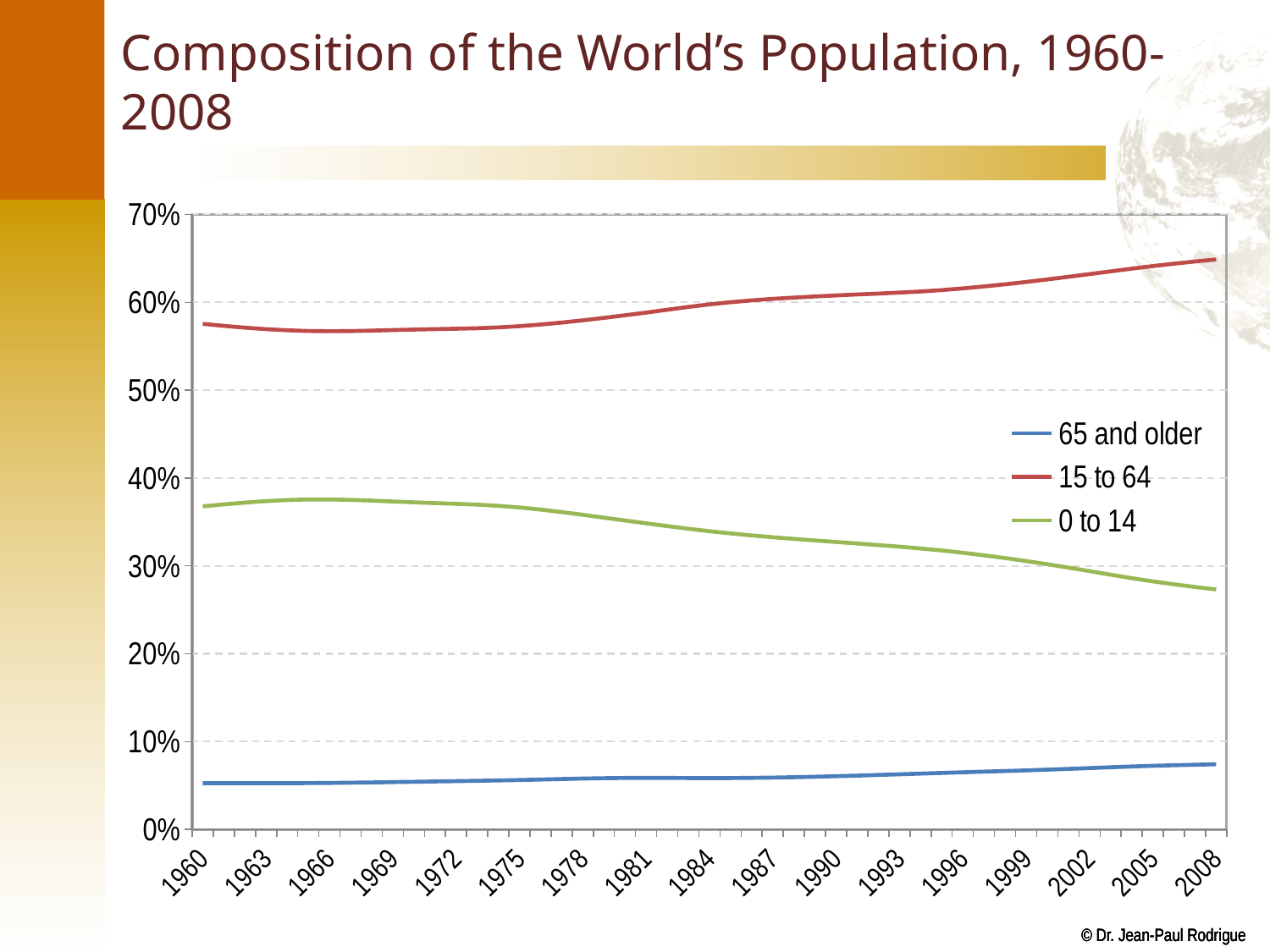
Does the 0 to 14 series rise or fall overall from 1960 to 2008? Fall Is the value for the 15 to 64 series in 2008 greater or less than 60%? greater What kind of chart is shown on the slide? Line chart In 2008, which series has the larger value: 15 to 64 or 0 to 14? 15 to 64 Is the value for the 65 and older series in 2008 greater or less than 10%? less Is the value for the 0 to 14 series in 1960 greater or less than 30%? greater How many series does the legend list? 3 Which series has the lowest values across the whole period? 65 and older Does the 15 to 64 series rise or fall overall from 1960 to 2008? Rise How many year labels are shown along the x axis? 17 What colour is the line for the 0 to 14 series? Green